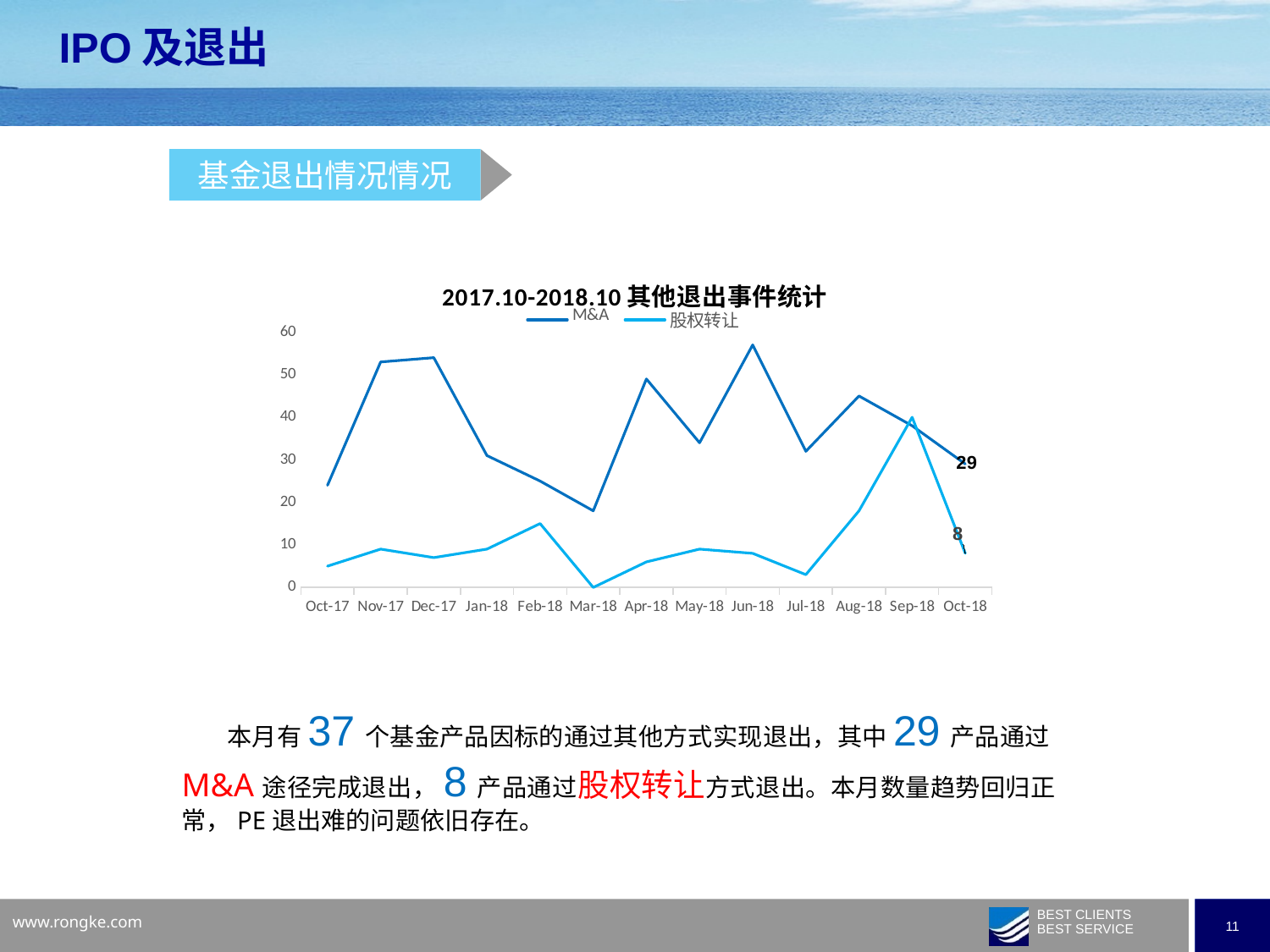
In which month does the 股权转让 series reach its lowest value? Mar-18 How many months are plotted along the x axis? 13 What is the difference between the M&A value and the 股权转让 value for Oct-18? 21 What type of chart is shown on the slide? Line chart For Oct-18, which series has the larger value, M&A or 股权转让? M&A Is the M&A value for Jun-18 greater or less than 50? greater What is the value of the 股权转让 series for Oct-18? 8 In which month does the 股权转让 series reach its highest value? Sep-18 What is the value of the M&A series for Oct-18? 29 What is the combined value of the M&A and 股权转让 series for Oct-18? 37 Is the M&A value for Mar-18 greater or less than 20? less How many series does the legend list? 2